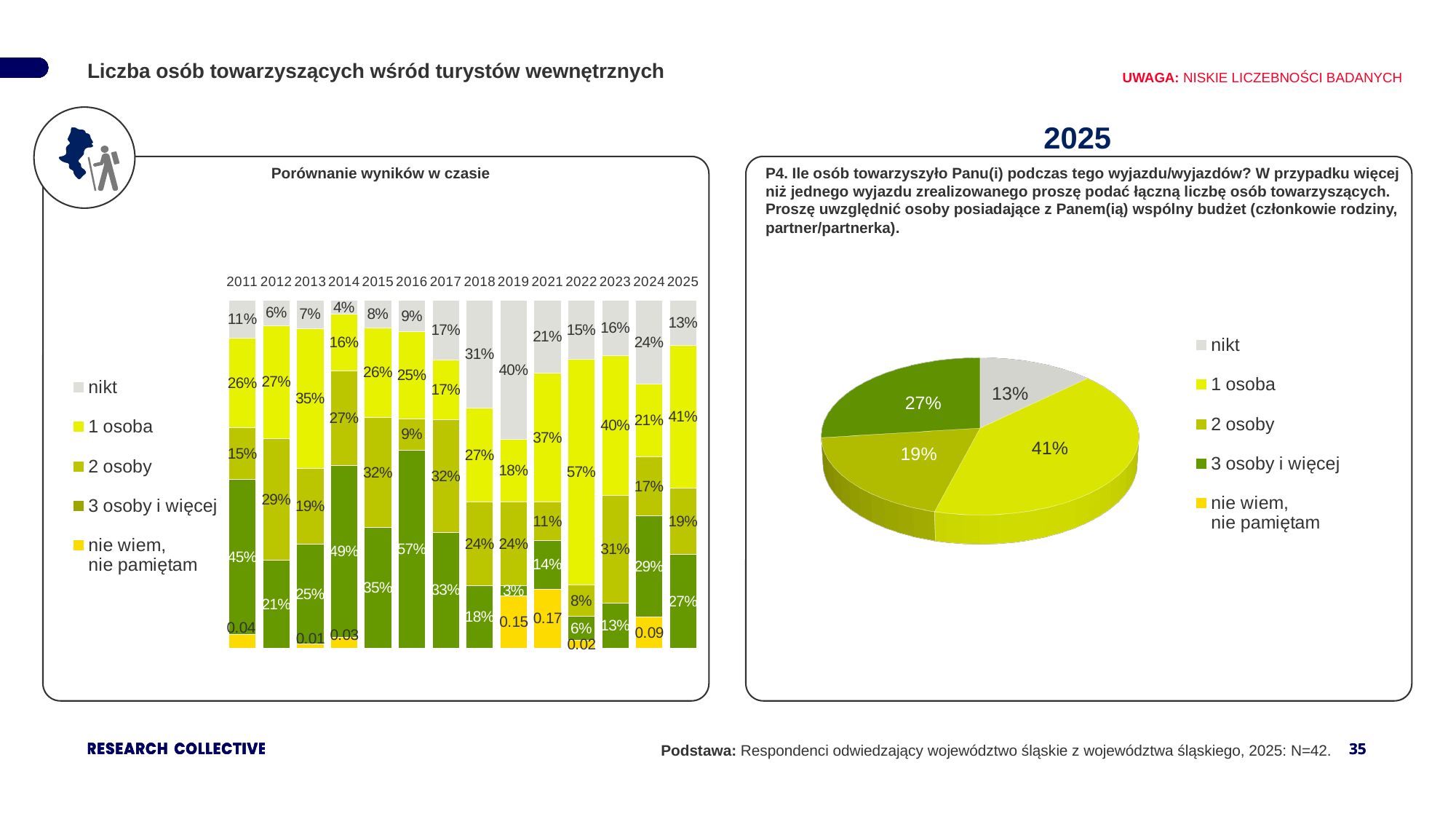
In the chart 'Porównanie wyników w czasie', which year has the highest value for 'nikt'? 2019 In the chart 'Porównanie wyników w czasie', what is the value for '3 osoby i więcej' in 2016? 57% What kind of chart is shown on the right side of the slide for 2025? Pie chart What kind of chart is 'Porównanie wyników w czasie'? Stacked bar chart In the pie chart for 2025, how many percentage points larger is '3 osoby i więcej' than '2 osoby'? 8 percentage points In the pie chart for 2025, what share is shown for '1 osoba'? 41% In the chart 'Porównanie wyników w czasie', what is the value for 'nikt' in 2019? 40% In the chart 'Porównanie wyników w czasie', how many years are shown on the x axis? 14 In the pie chart for 2025, which category has the largest slice? 1 osoba In the chart 'Porównanie wyników w czasie', how many series does the legend list? 5 In the pie chart for 2025, which category has the smallest slice? nikt In the chart 'Porównanie wyników w czasie', is the value for '3 osoby i więcej' larger in 2014 or in 2024? 2014